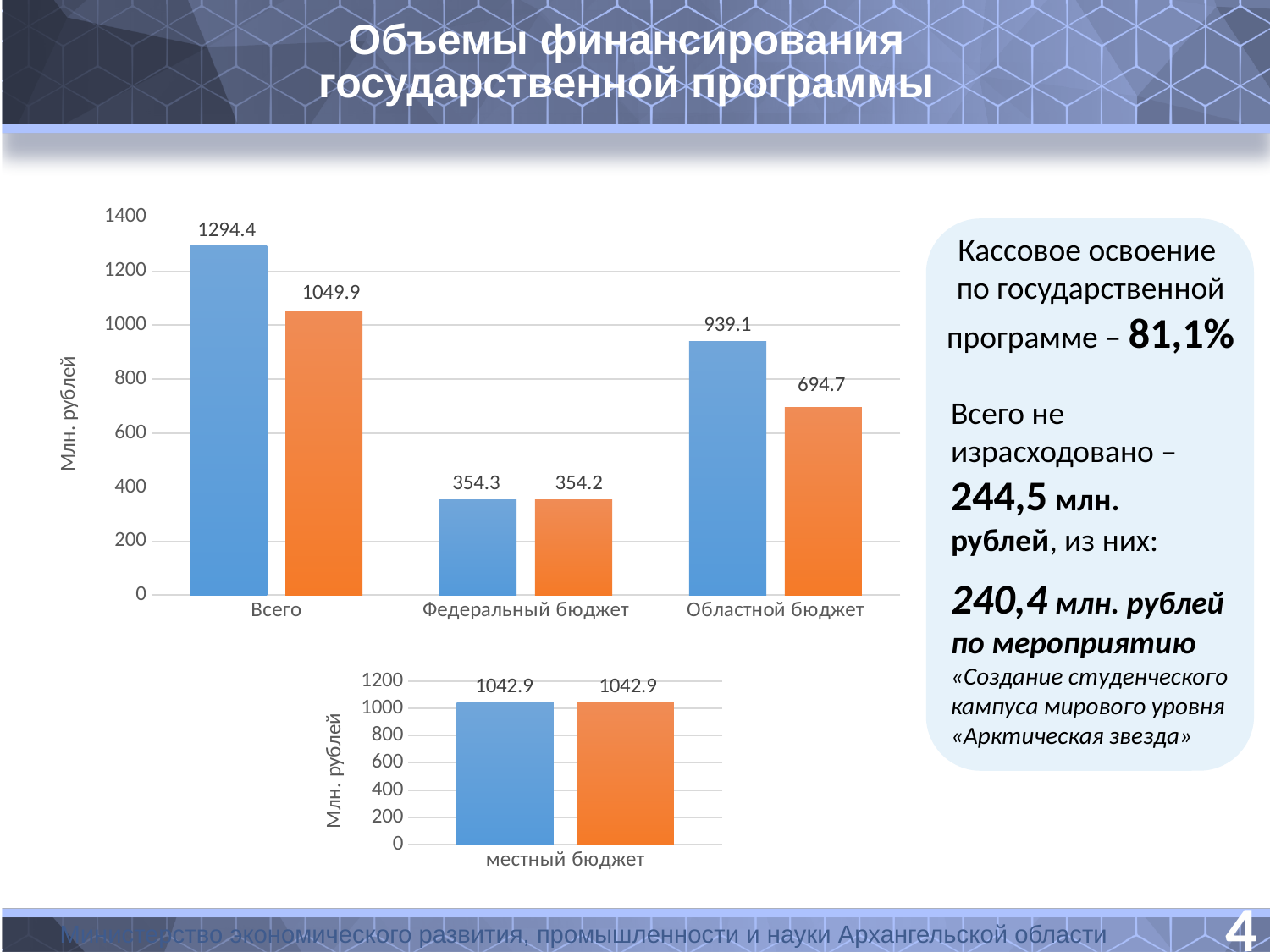
In the top chart, what is the value of the orange bar for Всего? 1049.9 In the bottom chart, what is the value of the blue bar for местный бюджет? 1042.9 What is the y-axis label of the top chart? Млн. рублей How many categories are shown on the x axis of the top chart? 3 In the top chart, what is the value of the blue bar for Всего? 1294.4 In the top chart, what is the difference between the blue and orange bars for Всего? 244.5 In the top chart, what is the difference between the blue and orange bars for Областной бюджет? 244.4 In the top chart, which is larger for Областной бюджет: the blue bar or the orange bar? the blue bar In the top chart, what is the value of the orange bar for Федеральный бюджет? 354.2 In the top chart, which category has the lowest blue bar? Федеральный бюджет What type of chart is the bottom chart? bar chart In the top chart, what is the value of the blue bar for Областной бюджет? 939.1